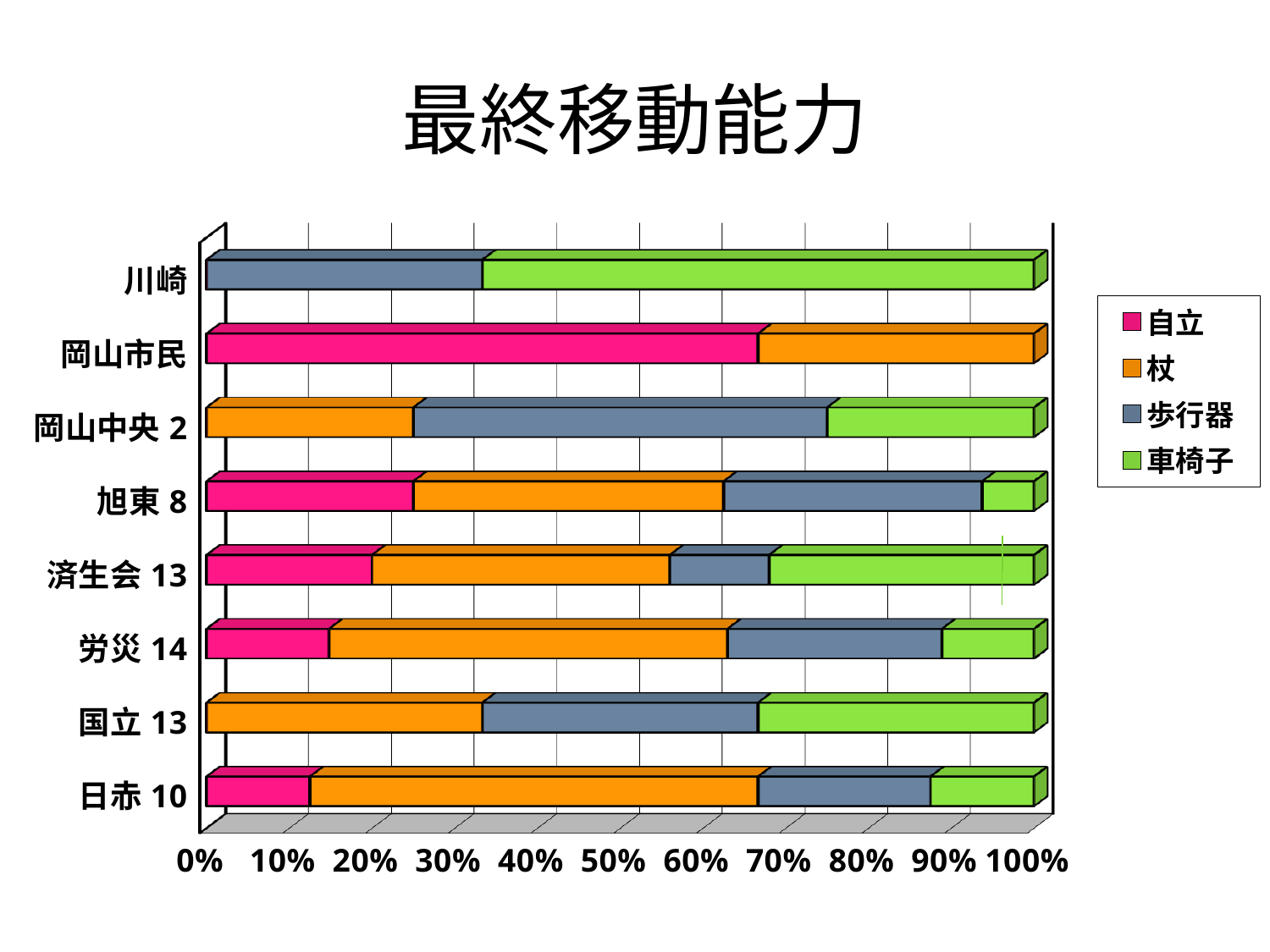
What is the title of the chart? 最終移動能力 Which category has the largest 自立 share? 岡山市民 What kind of chart is shown on the slide? Stacked bar chart How many categories (hospitals) are plotted on the chart? 8 Which series is shown in green in the legend? 車椅子 Is the 車椅子 share for 旭東 8 greater or less than 10%? less How many series does the legend list? 4 Is the 自立 share for 労災 14 greater or less than 20%? less For 岡山市民, which is larger, the 自立 share or the 杖 share? 自立 For 川崎, which is larger, the 歩行器 share or the 車椅子 share? 車椅子 Is the 自立 share for 岡山市民 greater or less than 60%? greater Which category has the largest 車椅子 share? 川崎